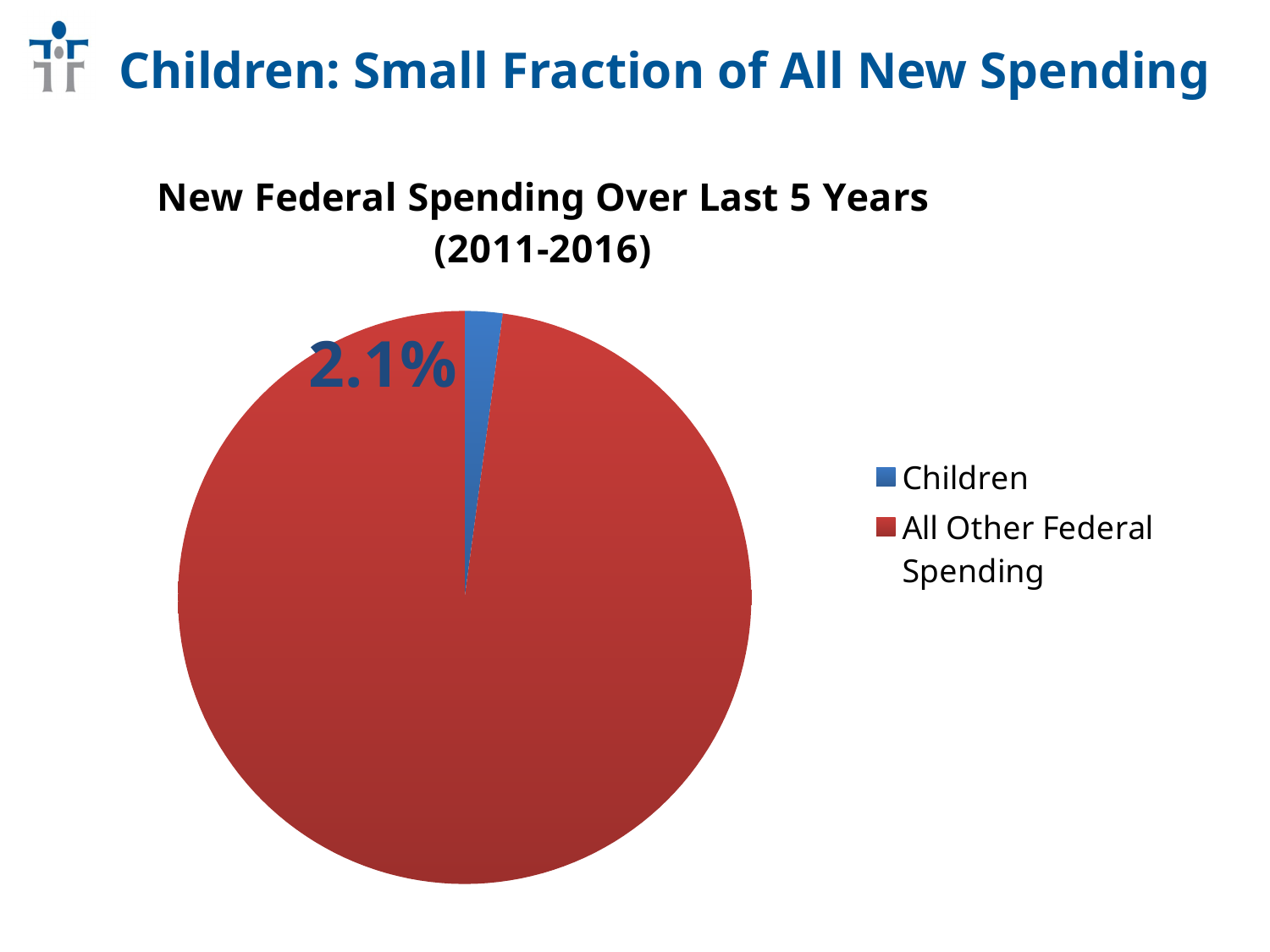
Which is larger, the Children slice or the All Other Federal Spending slice? All Other Federal Spending How many entries does the legend list? 2 What colour is the Children slice? blue What is the title of the chart? New Federal Spending Over Last 5 Years (2011-2016) What kind of chart is shown on the slide? pie chart Is the share for Children greater or less than 50%? less Which slice of the pie is the largest? All Other Federal Spending What share of new federal spending went to Children? 2.1% Which slice of the pie is the smallest? Children How many slices does the pie chart have? 2